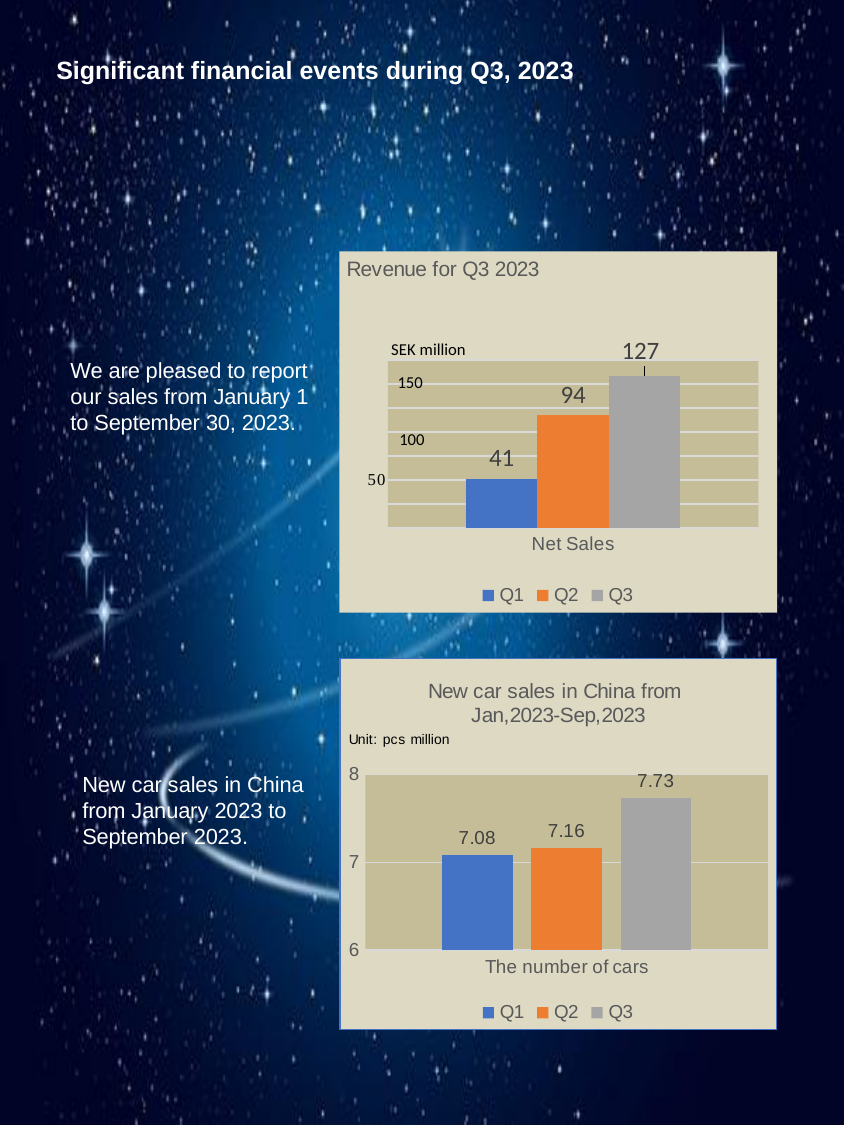
In the 'New car sales in China from Jan,2023-Sep,2023' chart, which quarter has the lowest value? Q1 In the 'New car sales in China from Jan,2023-Sep,2023' chart, which is larger, Q1 or Q2? Q2 In the 'New car sales in China from Jan,2023-Sep,2023' chart, what is the difference between Q3 and Q2? 0.57 What kind of chart is the 'New car sales in China from Jan,2023-Sep,2023' chart? bar chart In the 'Revenue for Q3 2023' chart, which quarter has the highest net sales? Q3 In the 'Revenue for Q3 2023' chart, what is the difference between Q3 and Q1? 86 In the 'Revenue for Q3 2023' chart, what is the value for Q2? 94 In the 'Revenue for Q3 2023' chart, what is the value for Q1? 41 In the 'Revenue for Q3 2023' chart, how many series does the legend list? 3 In the 'New car sales in China from Jan,2023-Sep,2023' chart, do the values rise or fall from Q1 to Q3? rise In the 'Revenue for Q3 2023' chart, what unit is shown above the axis? SEK million In the 'New car sales in China from Jan,2023-Sep,2023' chart, what is the value for Q3? 7.73